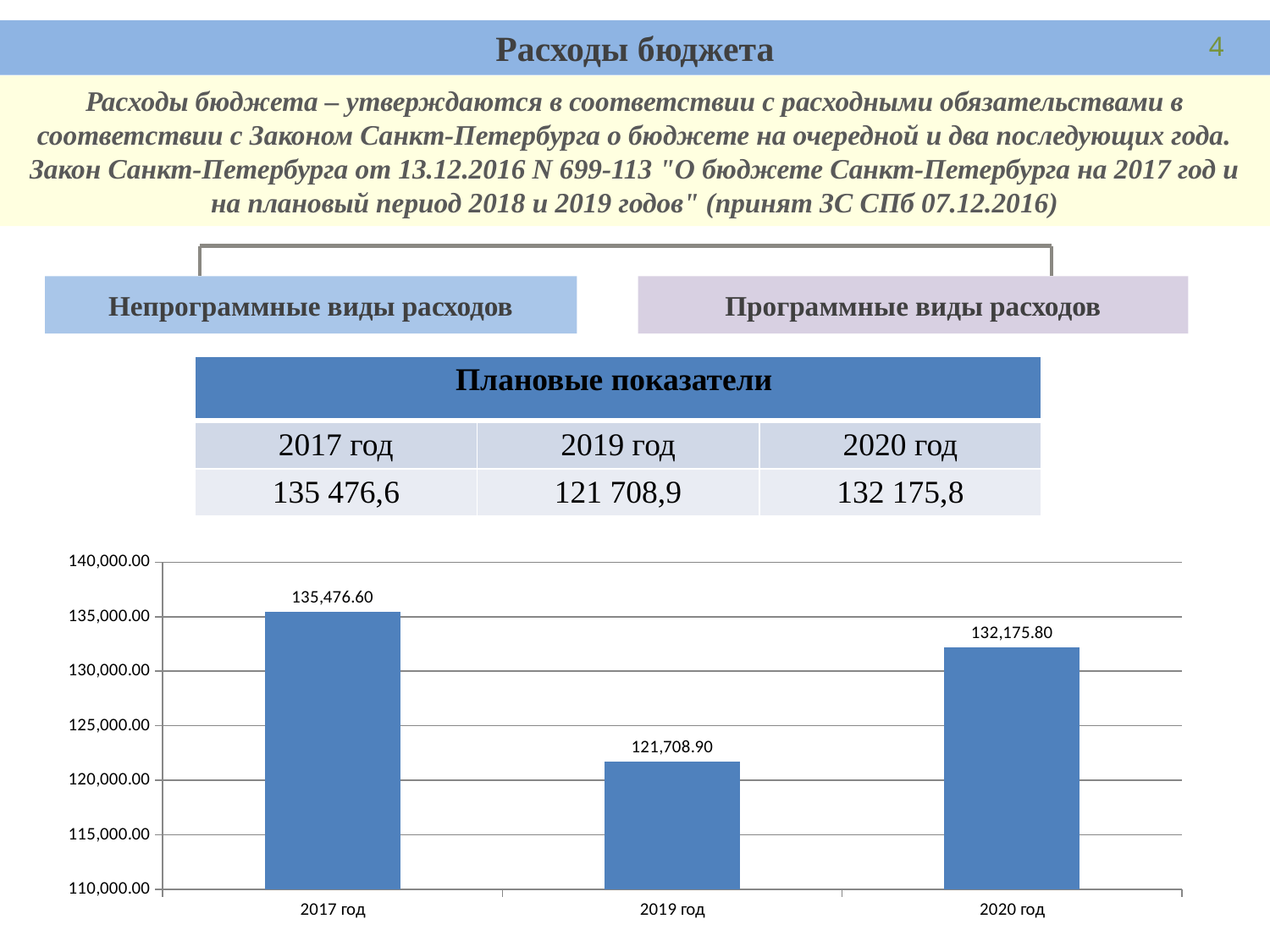
Which year has the highest value on the bar chart? 2017 год How many categories are plotted on the bar chart? 3 What is the value for 2019 год on the bar chart? 121,708.90 Is the value for 2019 год greater or less than 125,000.00? less What is the difference between the values for 2020 год and 2019 год? 10,466.90 Does the value rise or fall from 2017 год to 2019 год? fall Which year has the lowest value on the bar chart? 2019 год What is the value for 2020 год on the bar chart? 132,175.80 What kind of chart is shown at the bottom of the slide? bar chart What is the value for 2017 год on the bar chart? 135,476.60 What is the difference between the values for 2017 год and 2019 год? 13,767.70 Which is larger, the value for 2020 год or the value for 2019 год? 2020 год